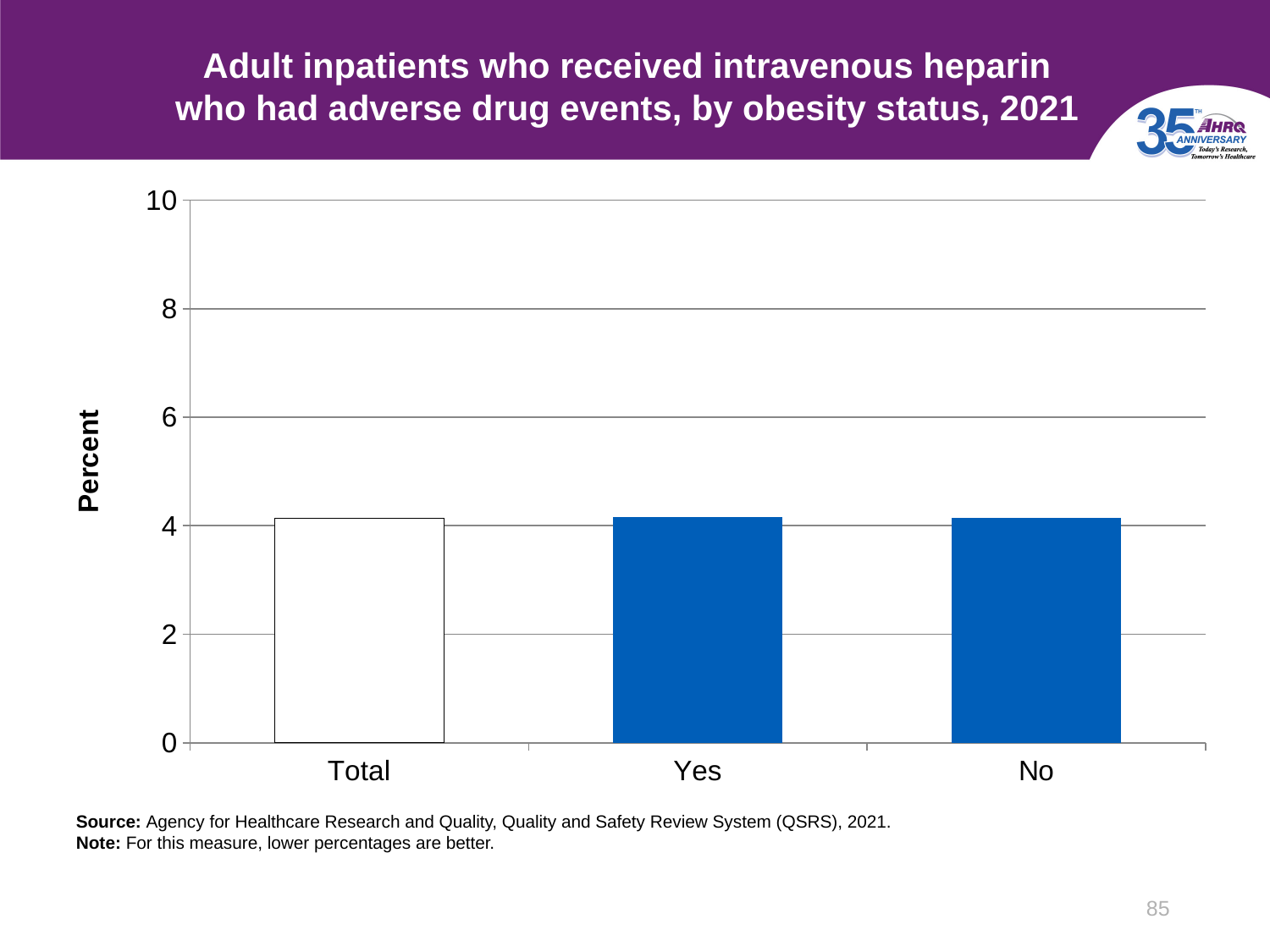
What kind of chart is shown on the slide? bar chart What is the label on the vertical axis of the chart? Percent What is the highest value shown on the vertical axis of the chart? 10 Is the value for Yes greater or less than 2? greater Is the value for No greater or less than 6? less How many categories are shown on the x axis of the chart? 3 Is the value for Total greater or less than 2? greater